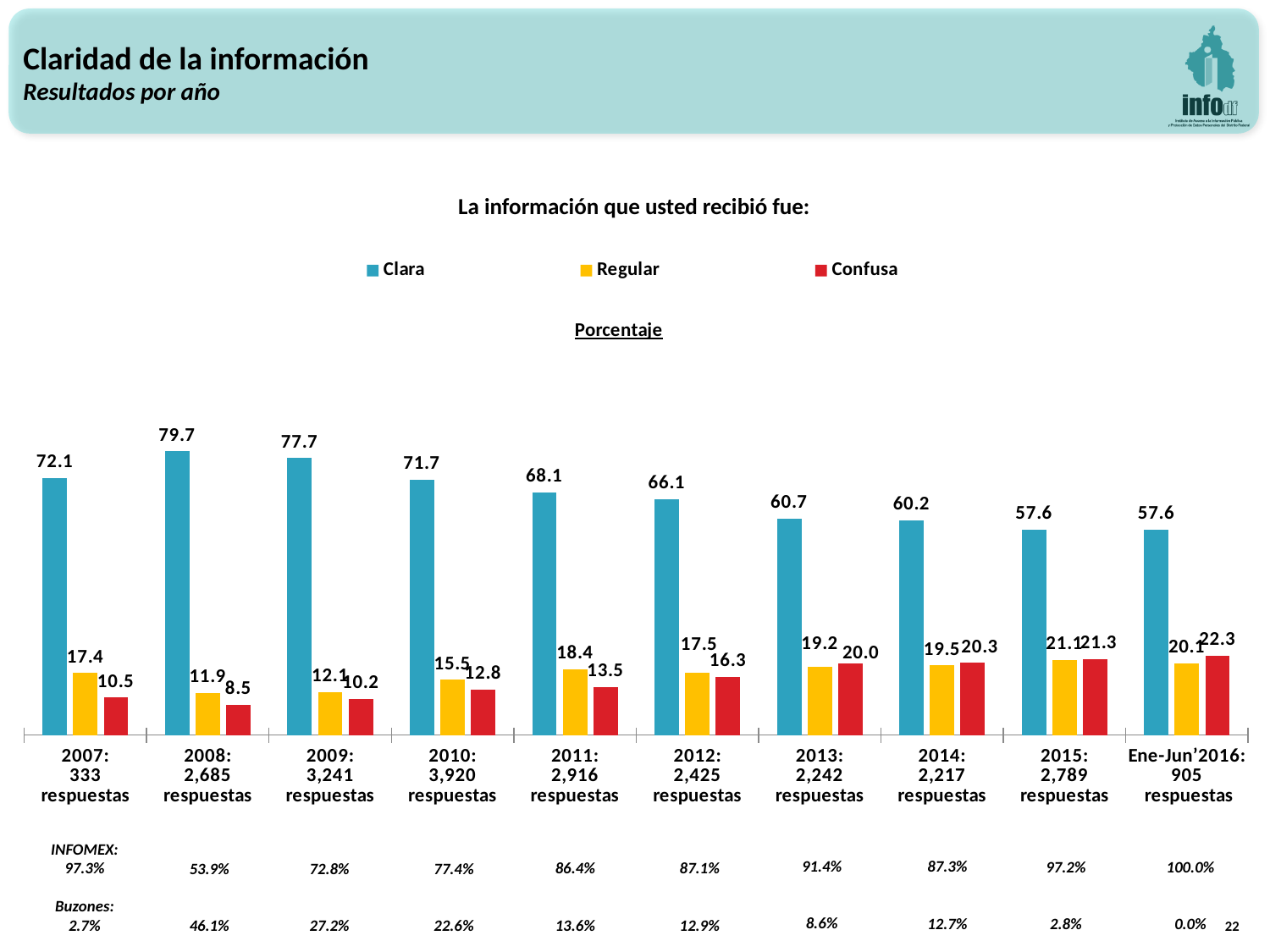
How many series does the legend list? 3 In which year is the Confusa value lowest? 2008 What kind of chart is shown? Bar chart How many year categories are shown on the x axis? 10 Overall, do the Clara values rise or fall from 2008 to Ene-Jun'2016? Fall In which year is the Clara value highest? 2008 What is the difference between the Clara value for 2007 and the Clara value for 2015? 14.5 What is the Confusa value for 2013? 20.0 What is the Clara value for 2008? 79.7 In which period is the Confusa value highest? Ene-Jun'2016 In 2012, which is larger: the Regular value or the Confusa value? Regular What is the Regular value for 2015? 21.1